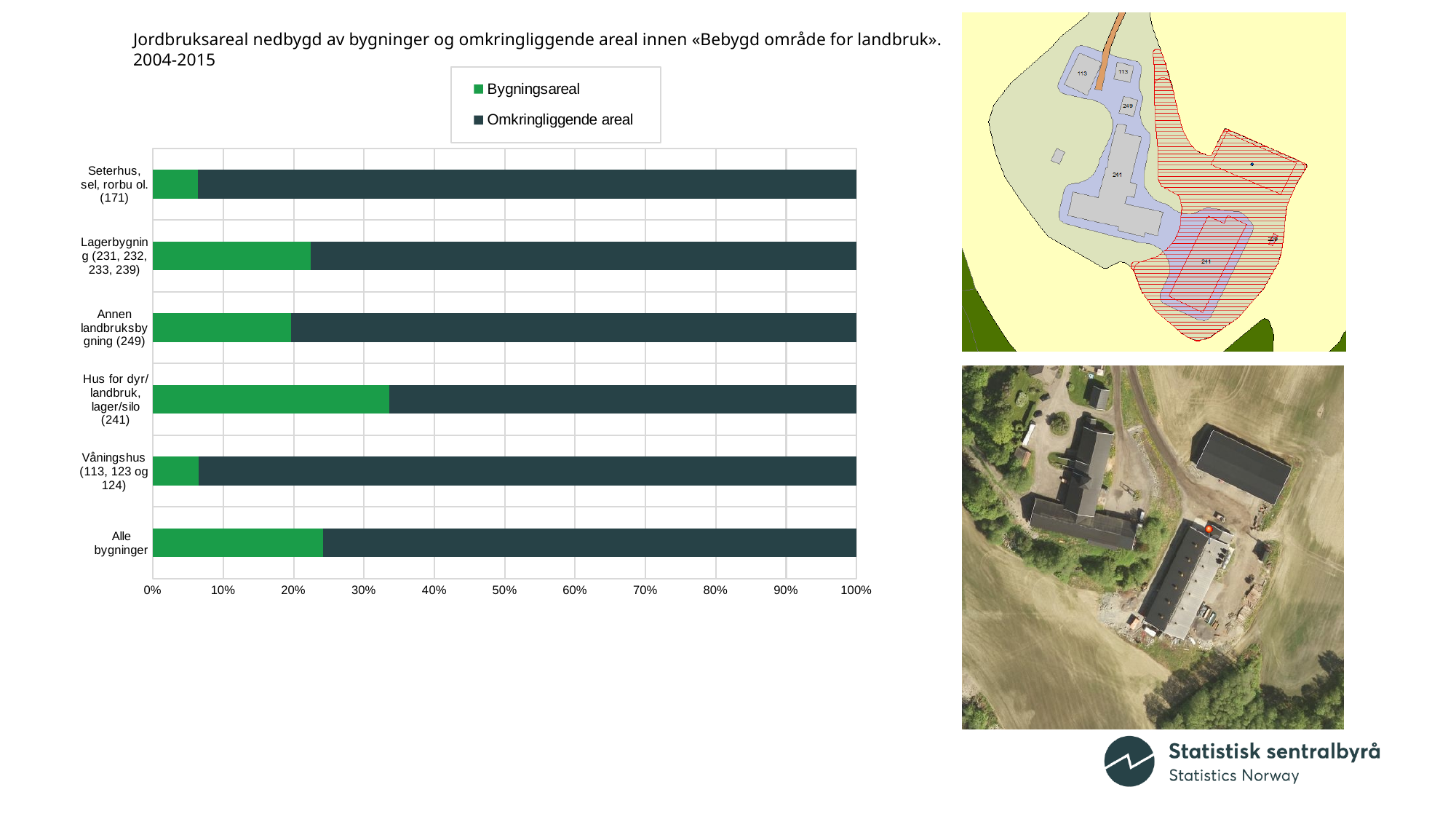
How many building categories are shown on the y axis of the chart? 6 Which category has the highest share of Bygningsareal? Hus for dyr/landbruk, lager/silo (241) How many series does the chart legend list? 2 Is the Bygningsareal share for Hus for dyr/landbruk, lager/silo (241) greater or less than 30%? greater Which has a larger Bygningsareal share: Hus for dyr/landbruk, lager/silo (241) or Lagerbygning (231, 232, 233, 239)? Hus for dyr/landbruk, lager/silo (241) Which has a larger Bygningsareal share: Alle bygninger or Seterhus, sel, rorbu ol. (171)? Alle bygninger Is the Bygningsareal share for Seterhus, sel, rorbu ol. (171) greater or less than 10%? less What kind of chart is shown on the slide? Stacked bar chart What period does the chart title say the data covers? 2004-2015 Is the Bygningsareal share for Alle bygninger greater or less than 20%? greater Which series is shown in green in the chart? Bygningsareal